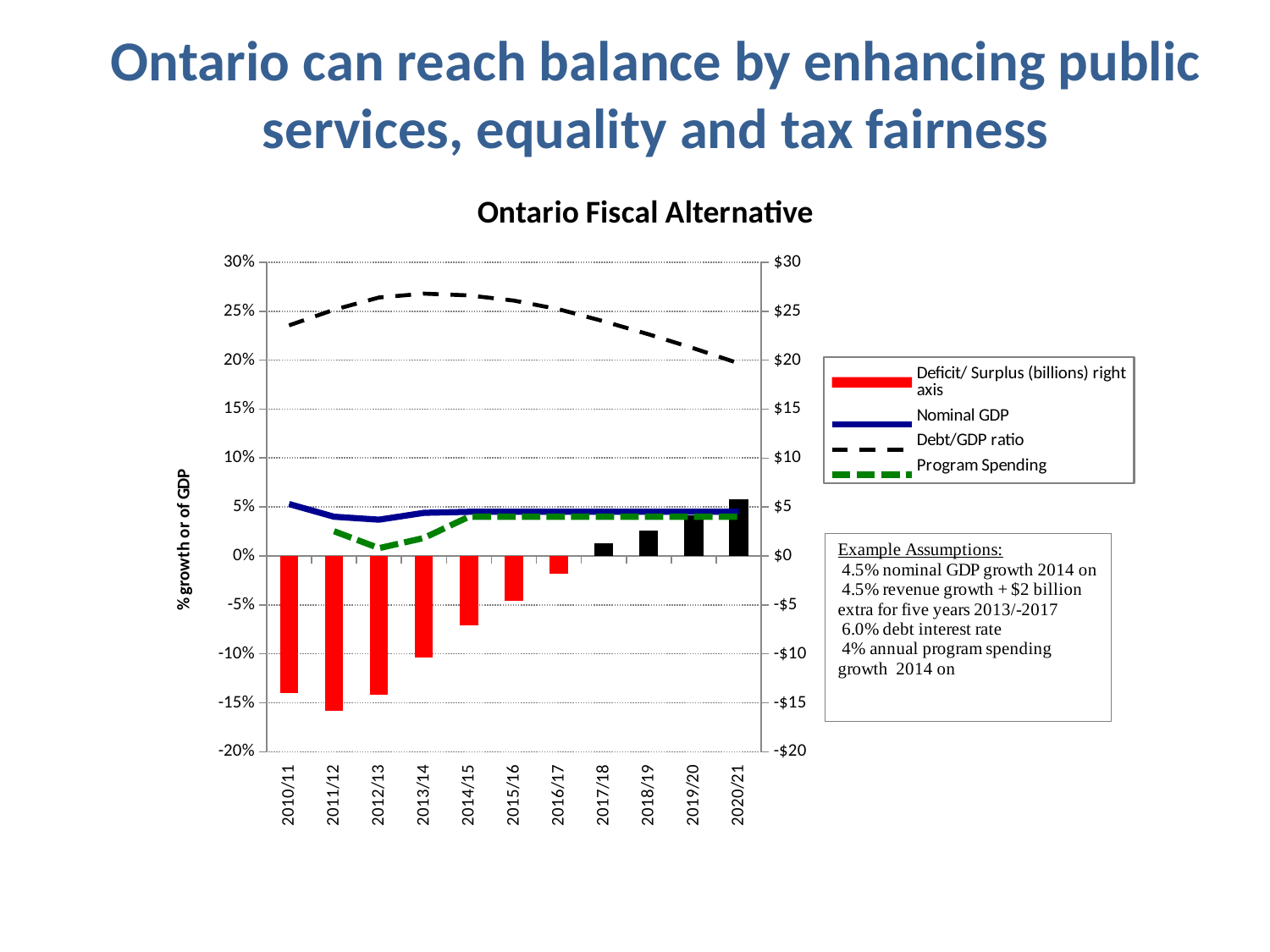
Is the Deficit/Surplus value for 2011/12 greater or less than -$15? less Which fiscal year has the lowest Deficit/Surplus bar? 2011/12 What is the title of the chart? Ontario Fiscal Alternative Which series does the legend say is plotted on the right axis? Deficit/ Surplus (billions) How many fiscal years are shown along the x axis of the chart? 11 How many series does the chart legend list? 4 What kind of chart is this? Combination bar and line chart Does the Deficit/Surplus series rise or fall from 2011/12 to 2020/21? rise Is the Debt/GDP ratio for 2010/11 greater or less than 20%? greater Which fiscal year has the highest Deficit/Surplus bar? 2020/21 Is the Deficit/Surplus value for 2020/21 greater or less than $5? greater